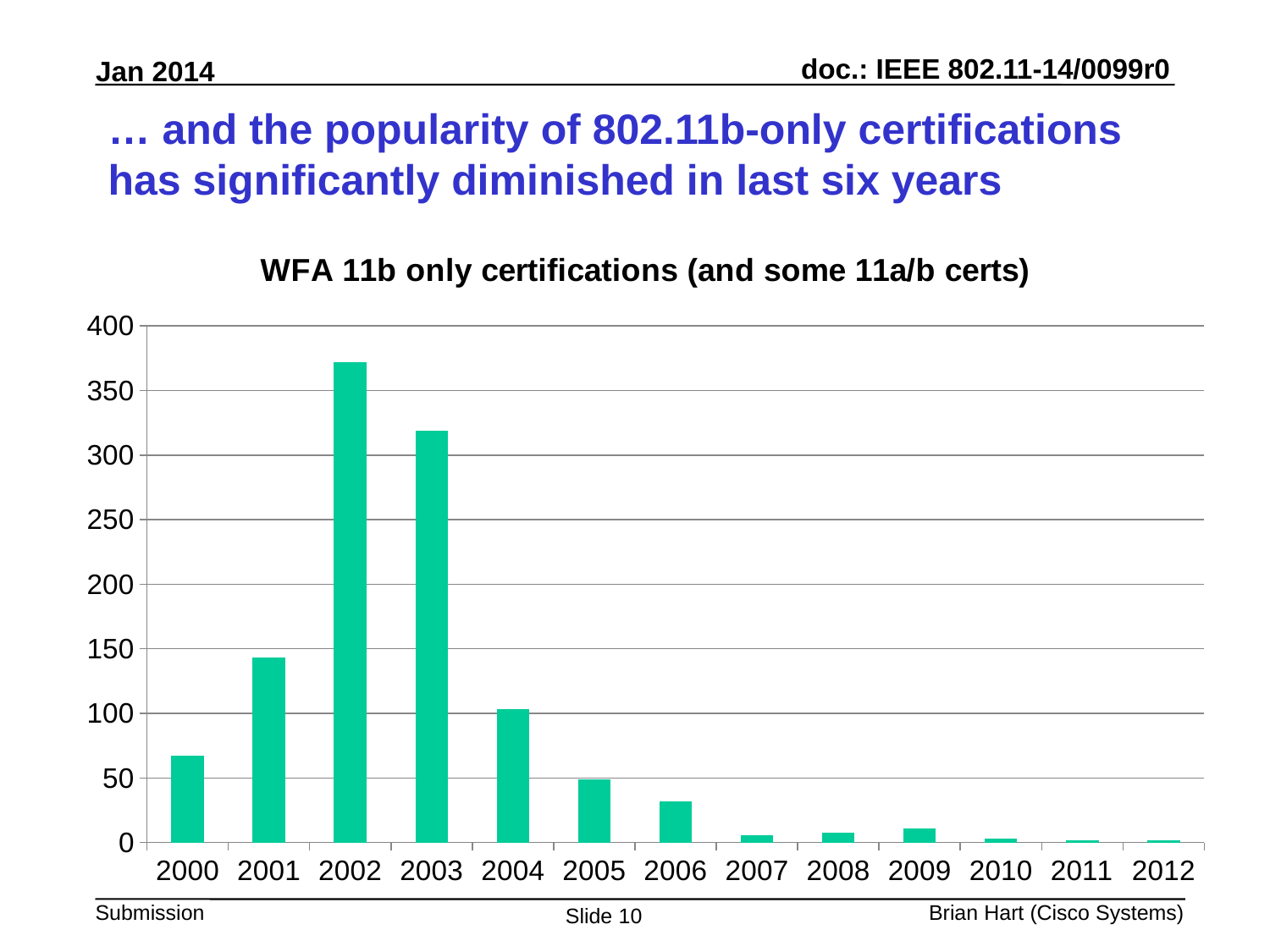
Is the value for 2006 greater or less than 50? less What kind of chart is shown on the slide? bar chart Which is larger, the value for 2003 or the value for 2004? 2003 Is the value for 2001 greater or less than 150? less Which year has the highest number of certifications? 2002 What is the title of the chart? WFA 11b only certifications (and some 11a/b certs) Is the value for 2000 greater or less than 50? greater Which is larger, the value for 2000 or the value for 2001? 2001 Do the values rise or fall from 2002 to 2012? fall How many years are shown on the x axis? 13